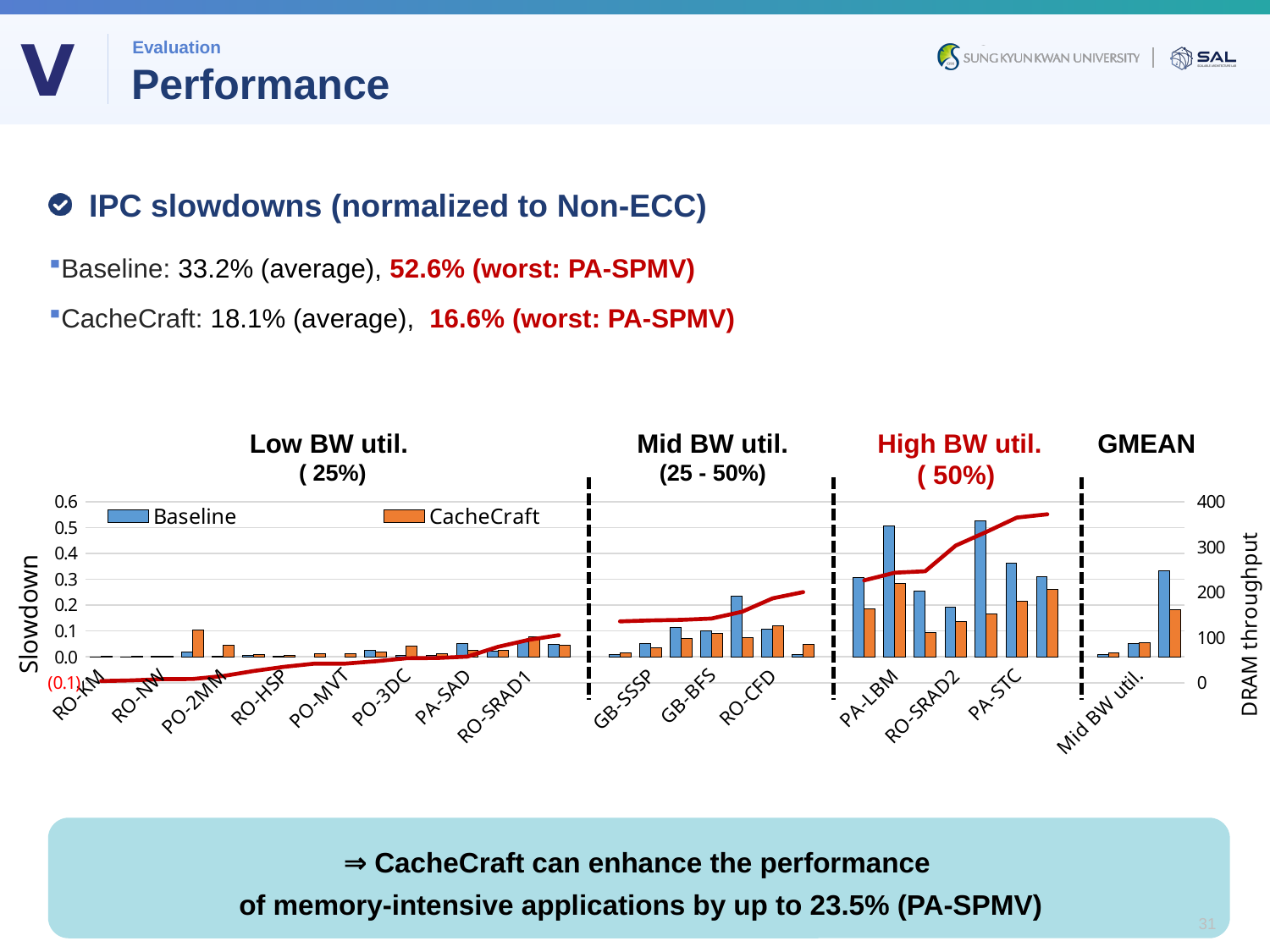
Does the red DRAM throughput line generally rise or fall from left to right across the chart? rise What is the title of the left vertical axis of the chart? Slowdown How many labelled groups (separated by dashed lines) does the chart divide the benchmarks into? 4 Is the tallest Baseline bar in the High BW util. group greater or less than 0.4? greater Which series has the tallest bar in the chart, Baseline or CacheCraft? Baseline How many series does the chart's legend list? 2 What are the two series named in the chart's legend? Baseline and CacheCraft What kind of chart is shown on the slide? combination bar and line chart What is the highest tick value shown on the left Slowdown axis? 0.6 Is the tallest CacheCraft bar in the chart greater or less than 0.4? less